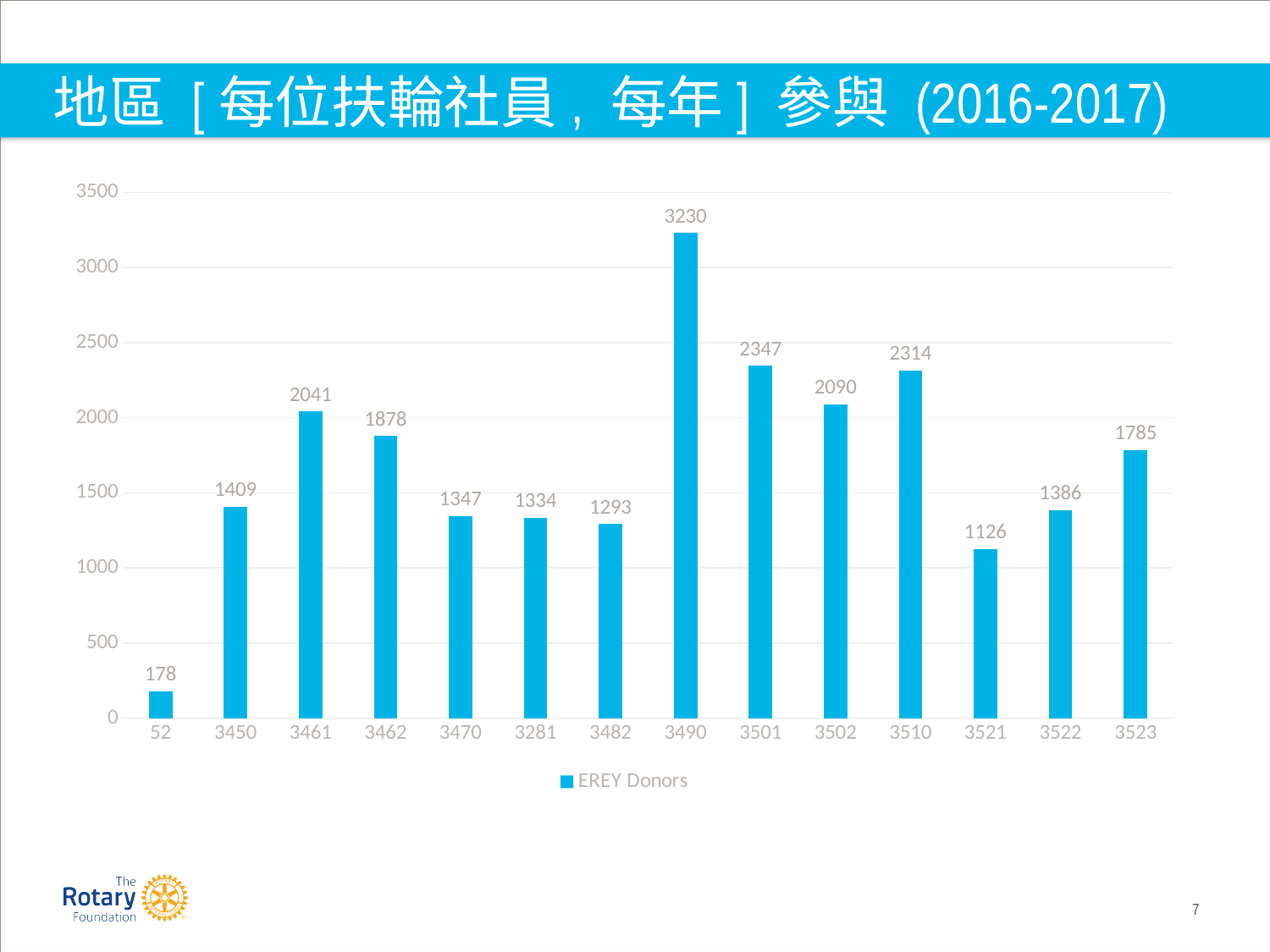
Which has a larger value, district 3461 or district 3502? 3502 Which district has the lowest number of EREY Donors? 52 What kind of chart is shown on the slide? bar chart What is the legend entry for the series shown? EREY Donors What is the value for district 3521? 1126 How many districts are shown on the x axis? 14 What is the difference between the values for districts 3501 and 3510? 33 Is the value for district 3523 greater or less than 1500? greater Which district has the highest number of EREY Donors? 3490 What is the value for district 3462? 1878 How many series does the legend list? 1 What is the value for district 3490? 3230